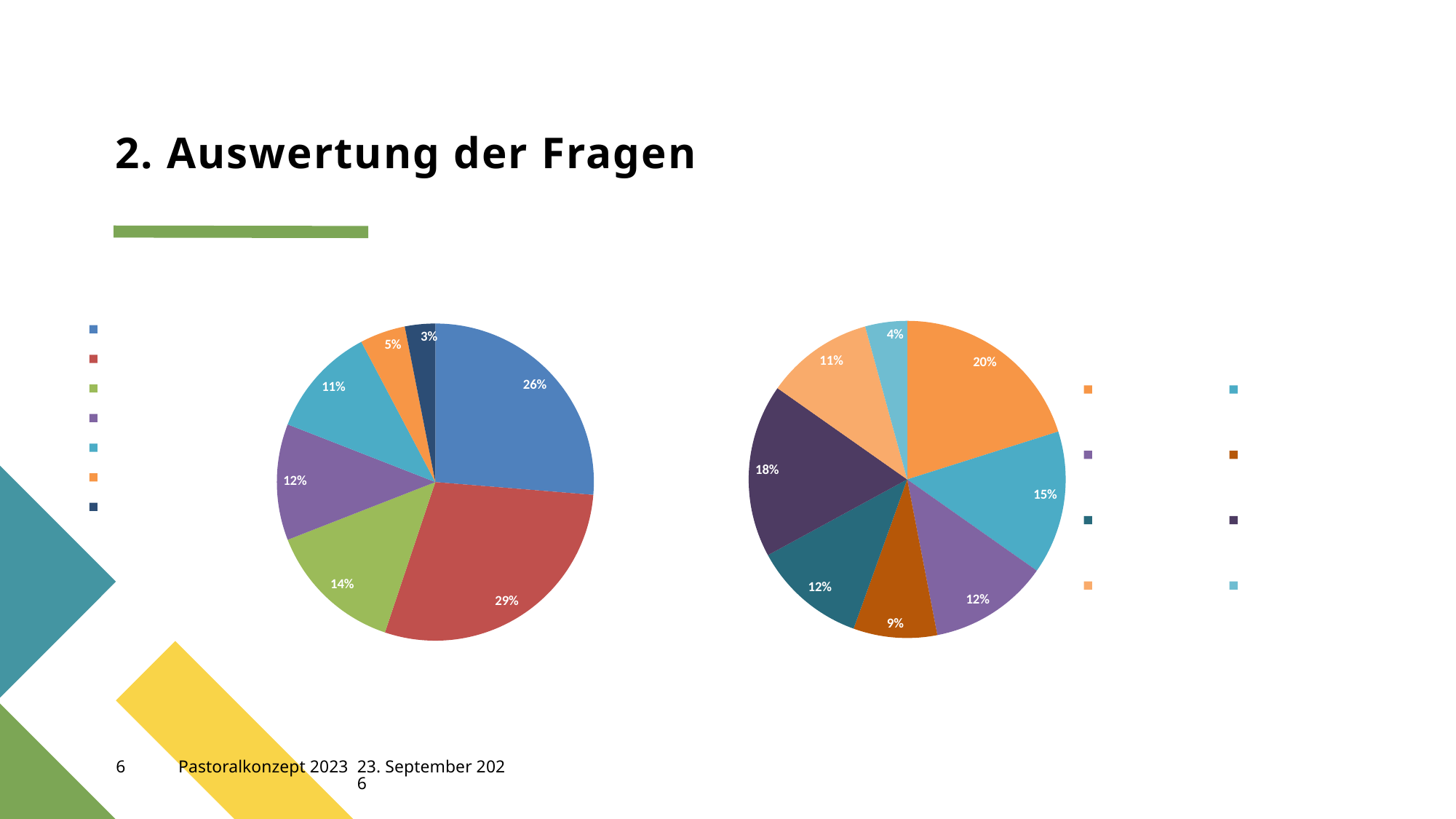
In the left pie chart, what percentage is shown on the blue slice? 26% In the right pie chart, what is the largest slice's percentage? 20% How many slices does the left pie chart have? 7 How many slices does the right pie chart have? 8 In the left pie chart, what is the largest slice's percentage? 29% In the right pie chart, which is larger: the orange slice at 20% or the teal slice at 15%? The orange slice (20%) In the right pie chart, what is the smallest slice's percentage? 4% In the left pie chart, what is the difference between the red slice (29%) and the green slice (14%)? 15% In the left pie chart, what percentage is shown on the red slice? 29% In the right pie chart, what percentage is shown on the dark purple slice? 18% What kind of chart is the left chart on the slide? Pie chart In the left pie chart, what is the smallest slice's percentage? 3%